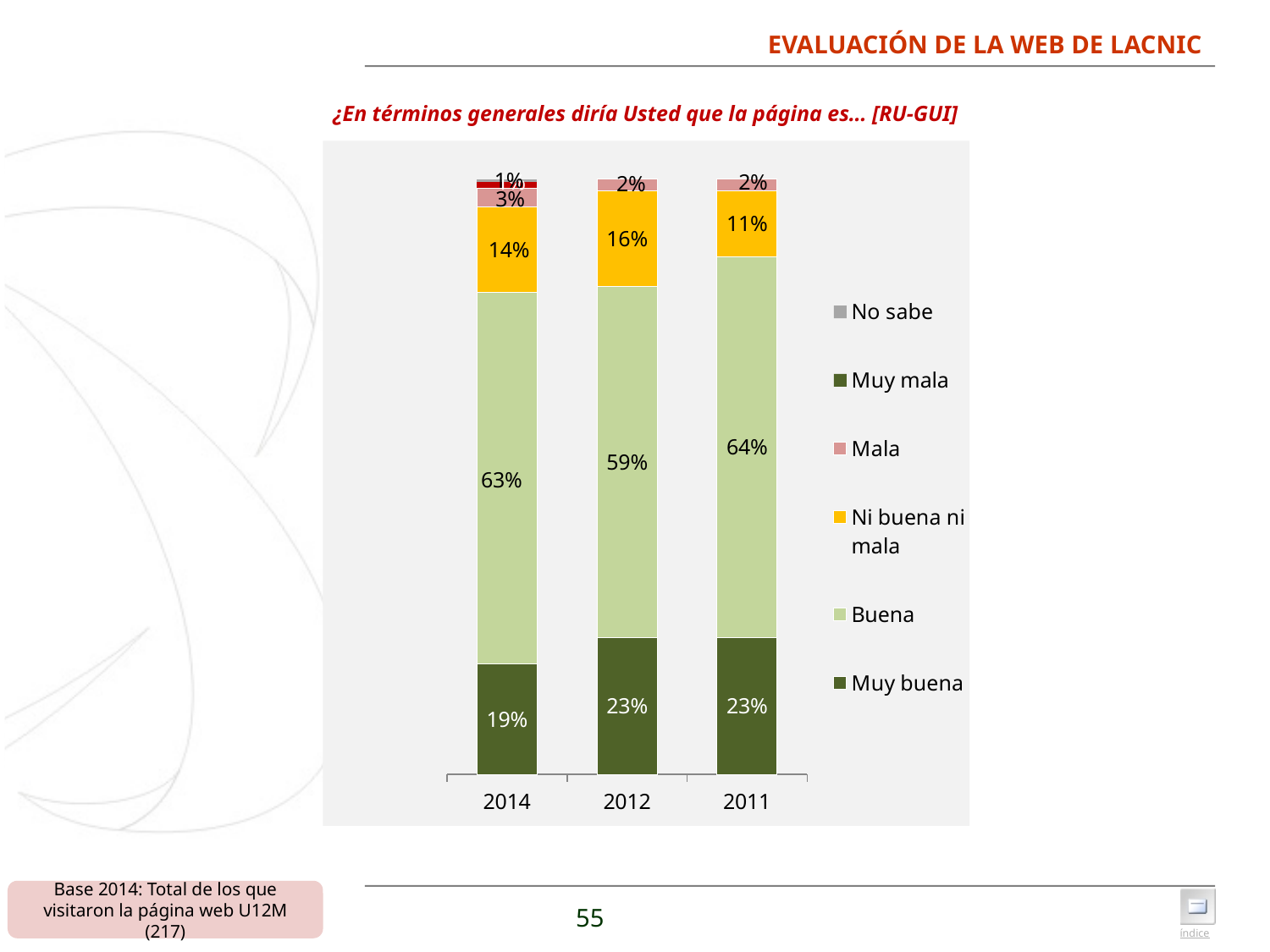
What kind of chart is shown on the slide? Stacked bar chart In which year is the "Muy buena" value lowest? 2014 What is the value for "Ni buena ni mala" in 2011? 11% In which year is the "Buena" value highest? 2011 What is the difference between the "Buena" values for 2011 and 2012? 5 percentage points Which legend entry is shown in yellow? Ni buena ni mala How many years are shown on the x axis? 3 Which is larger, the "Ni buena ni mala" value for 2012 or for 2014? 2012 How many series does the legend list? 6 What is the value for "Muy buena" in 2012? 23% What is the value for "Buena" in 2014? 63% What is the value for "Mala" in 2014? 3%